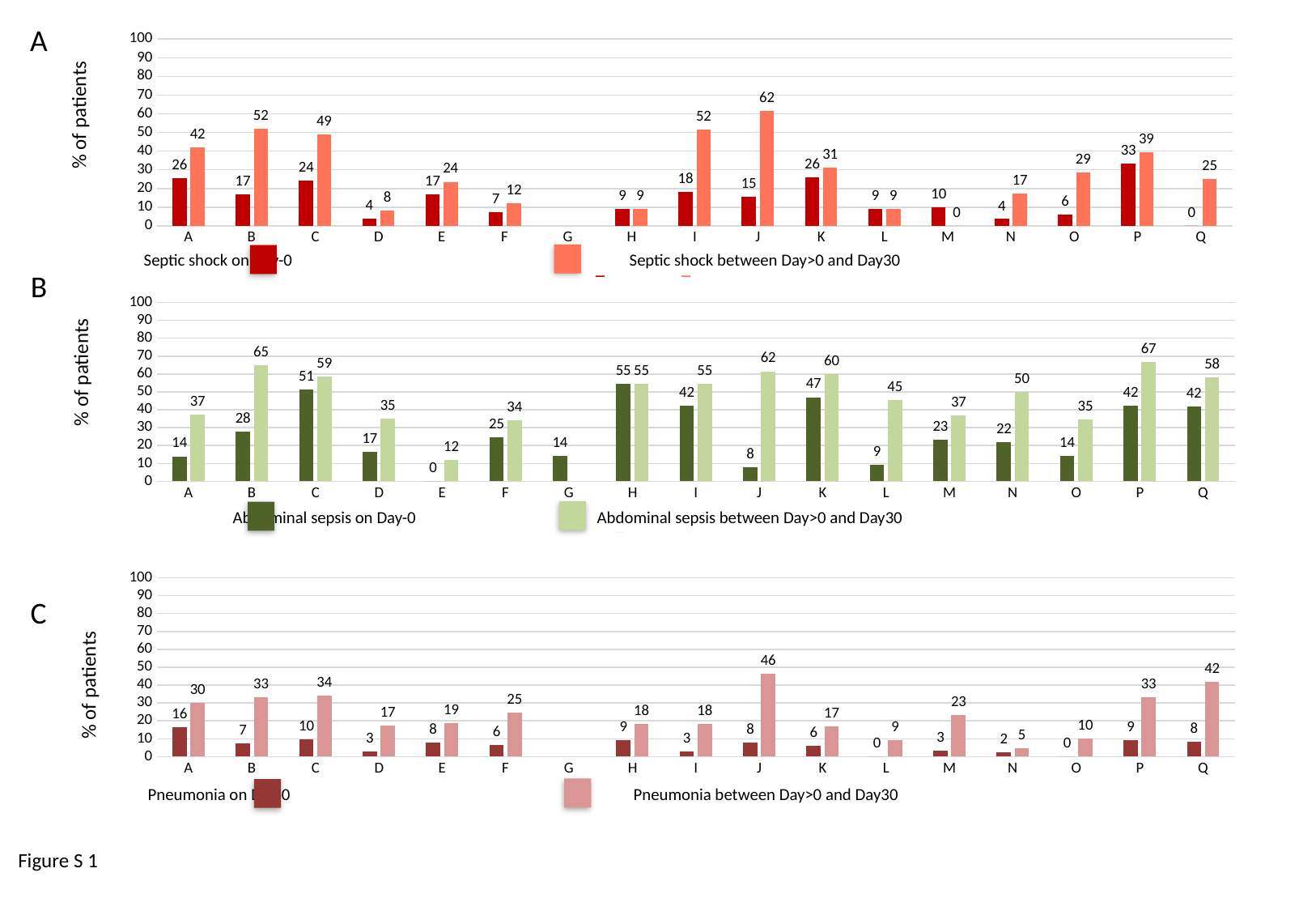
In chart A (septic shock), which center has the highest value for Septic shock on Day-0? P In chart C (pneumonia), which center has the highest value for Pneumonia between Day>0 and Day30? J In chart B (abdominal sepsis), which center has the highest value for Abdominal sepsis between Day>0 and Day30? P In chart A (septic shock), what is the difference between the Day>0 to Day30 value and the Day-0 value for center B? 35 In chart B (abdominal sepsis), which is larger for center C: the Day-0 value or the Day>0 to Day30 value? Day>0 to Day30 value In chart C (pneumonia), what is the value for Pneumonia on Day-0 for center A? 16 What type of chart is chart A (septic shock)? Bar chart In chart C (pneumonia), what is the difference between the Day>0 to Day30 value and the Day-0 value for center Q? 34 In chart A (septic shock), what is the value for Septic shock between Day>0 and Day30 for center J? 62 How many centers (categories) are shown on the x axis of chart B (abdominal sepsis)? 17 How many series does the legend of chart C (pneumonia) list? 2 In chart B (abdominal sepsis), what is the value for Abdominal sepsis on Day-0 for center H? 55